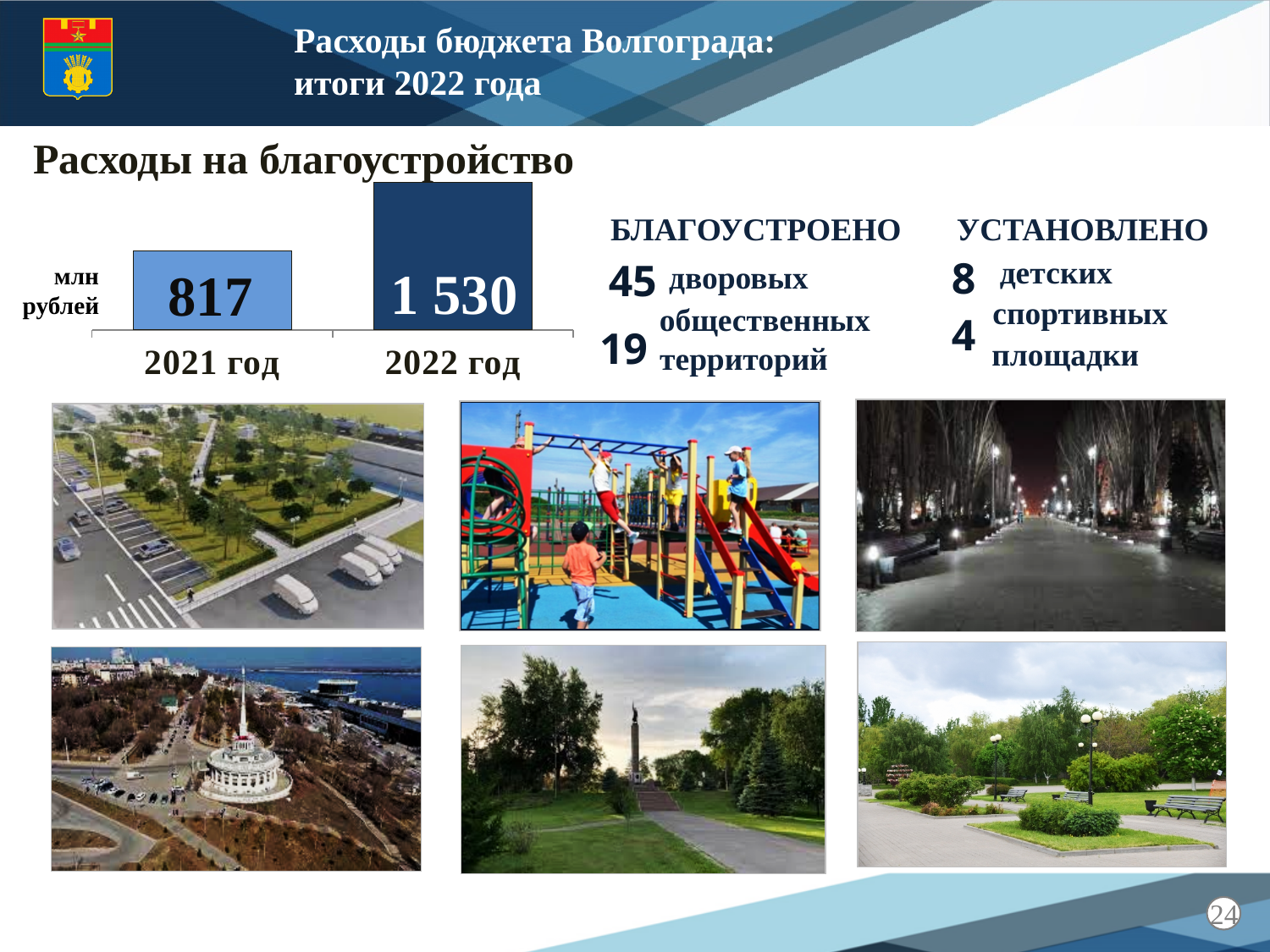
Which year has the lower value in the chart? 2021 год What is the title of the chart? Расходы на благоустройство What is the value for 2021 год in the chart? 817 What kind of chart is shown on the slide? bar chart Is the value for 2022 год larger or smaller than the value for 2021 год? larger What is the value for 2022 год in the chart? 1 530 In what units are the chart values given? млн рублей Do the values rise or fall from 2021 год to 2022 год? rise What is the difference between the values for 2022 год and 2021 год? 713 How many bars are shown in the chart? 2 Which year has the higher value in the chart? 2022 год